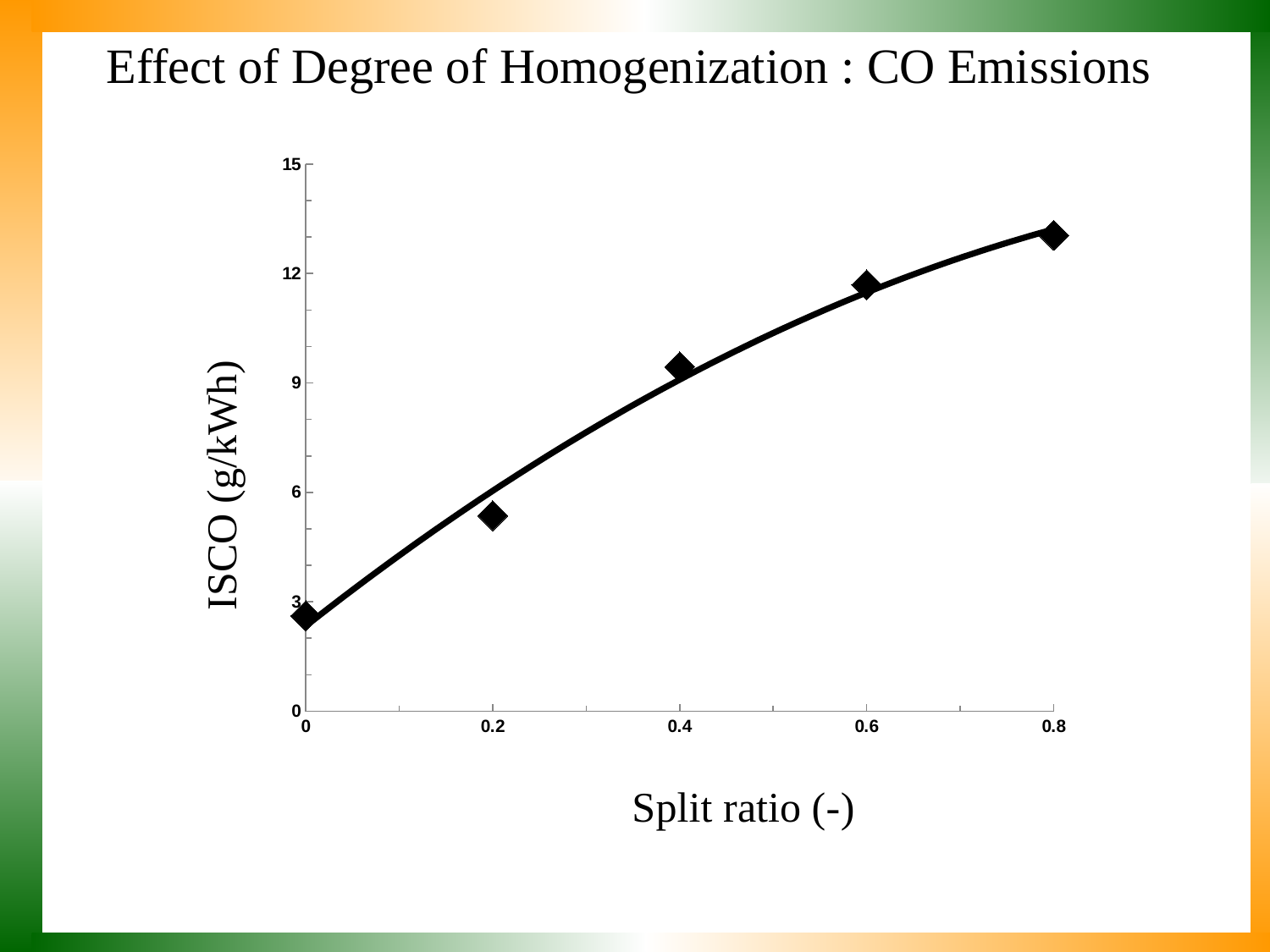
At which split ratio is ISCO highest? 0.8 What kind of chart is shown on the slide? scatter chart with a trend line How many data points are plotted on the chart? 5 Is the ISCO value at split ratio 0.4 greater or less than 9? greater Is the ISCO value at split ratio 0.2 greater or less than 6? less Which has the larger ISCO value, split ratio 0.2 or split ratio 0.4? 0.4 What is the label of the y axis? ISCO (g/kWh) Do the ISCO values rise or fall as the split ratio increases? rise Is the ISCO value at split ratio 0 greater or less than 3? less At which split ratio is ISCO lowest? 0